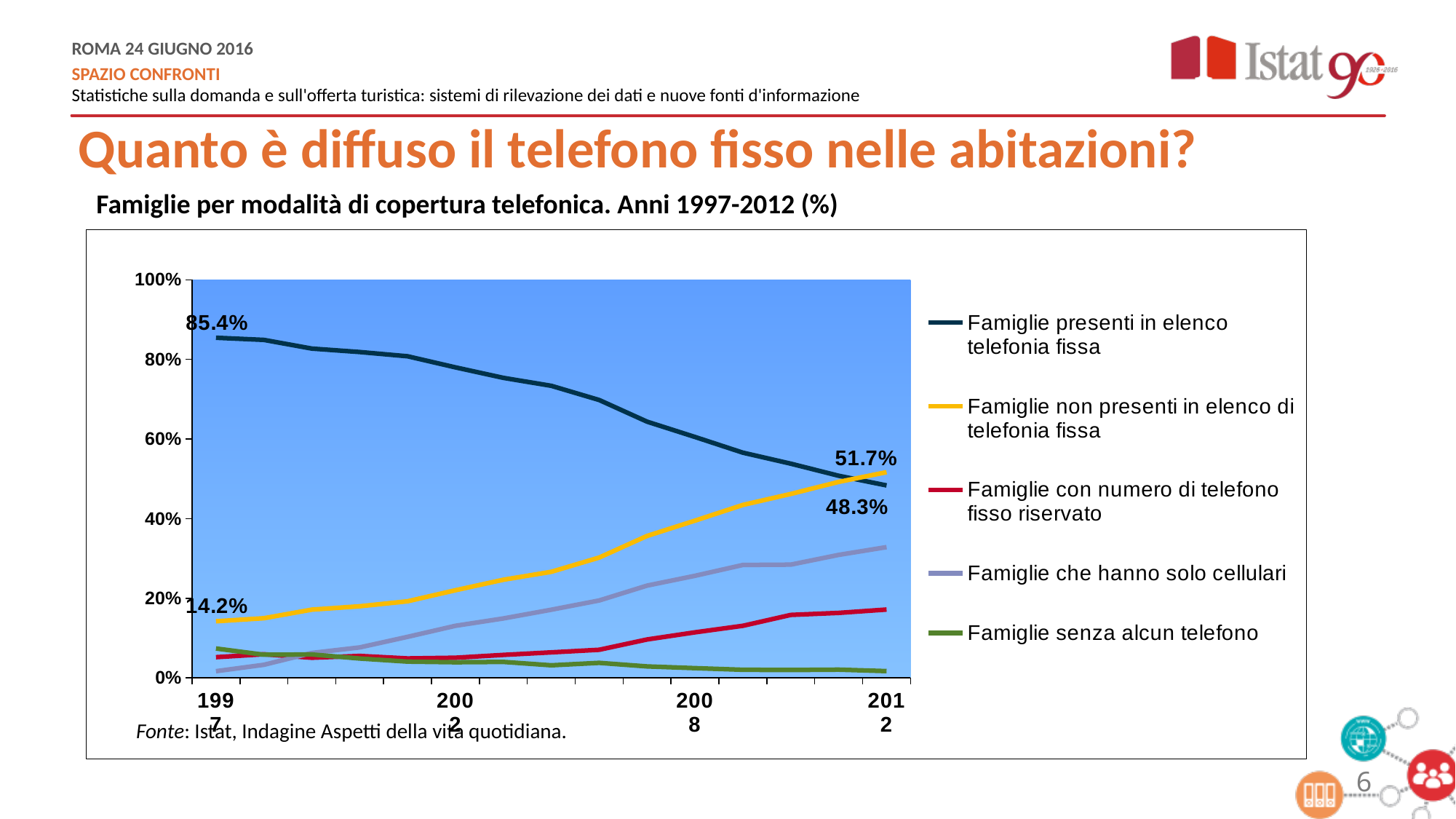
What is the difference between the 1997 values for 'Famiglie presenti in elenco telefonia fissa' and 'Famiglie non presenti in elenco di telefonia fissa'? 71.2 percentage points In 2012, which is larger: 'Famiglie non presenti in elenco di telefonia fissa' or 'Famiglie presenti in elenco telefonia fissa'? Famiglie non presenti in elenco di telefonia fissa Does the line for 'Famiglie presenti in elenco telefonia fissa' rise or fall from 1997 to 2012? fall Which series has the highest value in 1997? Famiglie presenti in elenco telefonia fissa What is the value for 'Famiglie presenti in elenco telefonia fissa' in 2012? 48.3% Does the line for 'Famiglie che hanno solo cellulari' rise or fall from 1997 to 2012? rise What kind of chart is shown on the slide? line chart What is the value for 'Famiglie non presenti in elenco di telefonia fissa' in 2012? 51.7% How many series does the legend list? 5 What is the value for 'Famiglie non presenti in elenco di telefonia fissa' in 1997? 14.2% What is the value for 'Famiglie presenti in elenco telefonia fissa' in 1997? 85.4% Is the value for 'Famiglie che hanno solo cellulari' in 2012 greater or less than 20%? greater